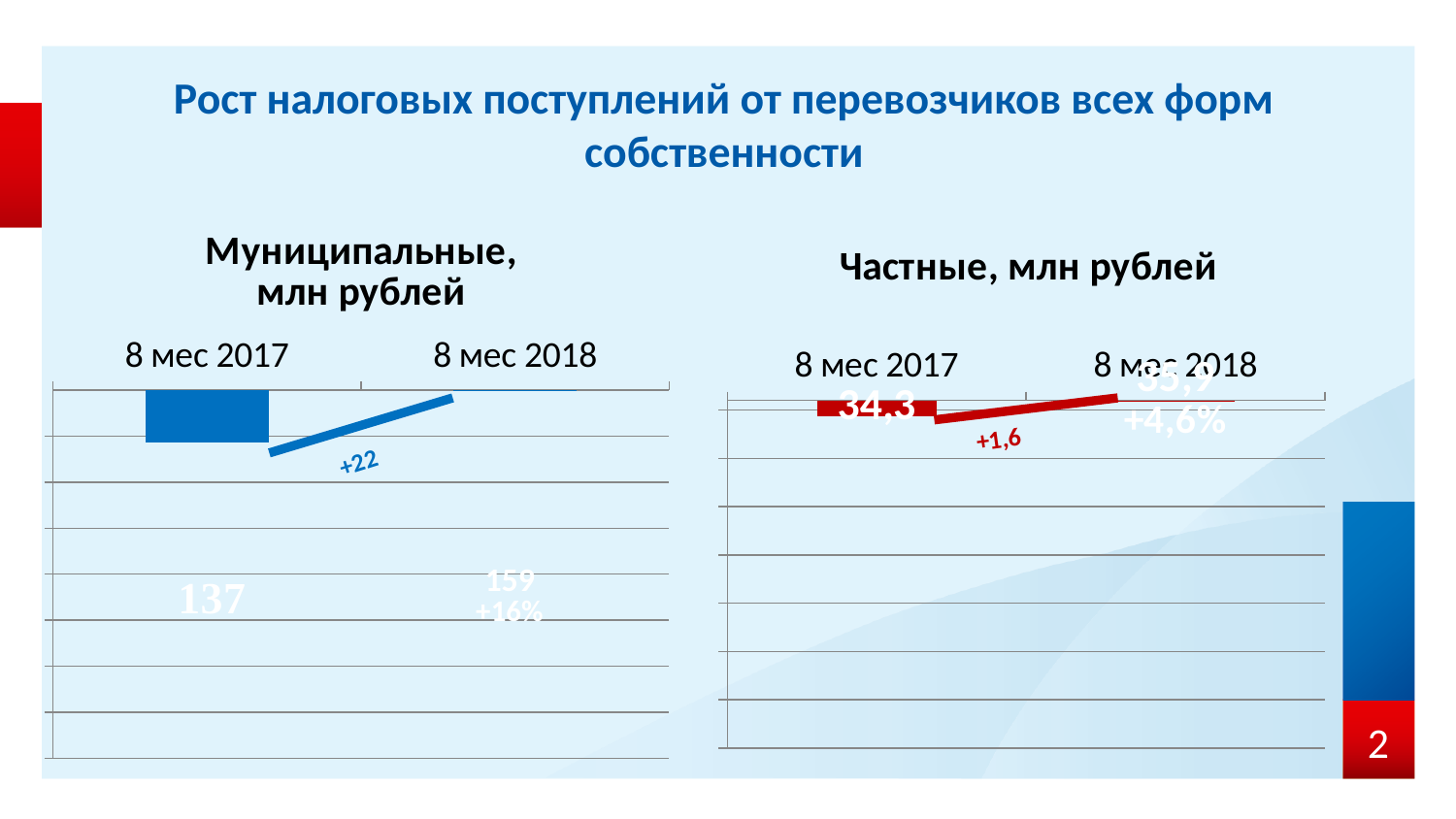
On the 'Муниципальные, млн рублей' chart, which period has the higher value, 8 мес 2017 or 8 мес 2018? 8 мес 2018 On the 'Муниципальные, млн рублей' chart, what is the difference between the 8 мес 2018 and 8 мес 2017 values? 22 On the 'Муниципальные, млн рублей' chart, what percentage growth is labelled next to the 8 мес 2018 value? +16% On the 'Частные, млн рублей' chart, what is the value for 8 мес 2017? 34,3 On the 'Частные, млн рублей' chart, which period has the lowest value? 8 мес 2017 How many categories are shown on the 'Муниципальные, млн рублей' chart? 2 On the 'Частные, млн рублей' chart, what is the difference between the 8 мес 2018 and 8 мес 2017 values? 1,6 On the 'Муниципальные, млн рублей' chart, what is the value for 8 мес 2017? 137 On the 'Муниципальные, млн рублей' chart, do the values rise or fall from 8 мес 2017 to 8 мес 2018? rise On the 'Муниципальные, млн рублей' chart, what is the value for 8 мес 2018? 159 What kind of chart is the 'Частные, млн рублей' chart? bar chart On the 'Частные, млн рублей' chart, what is the value for 8 мес 2018? 35,9